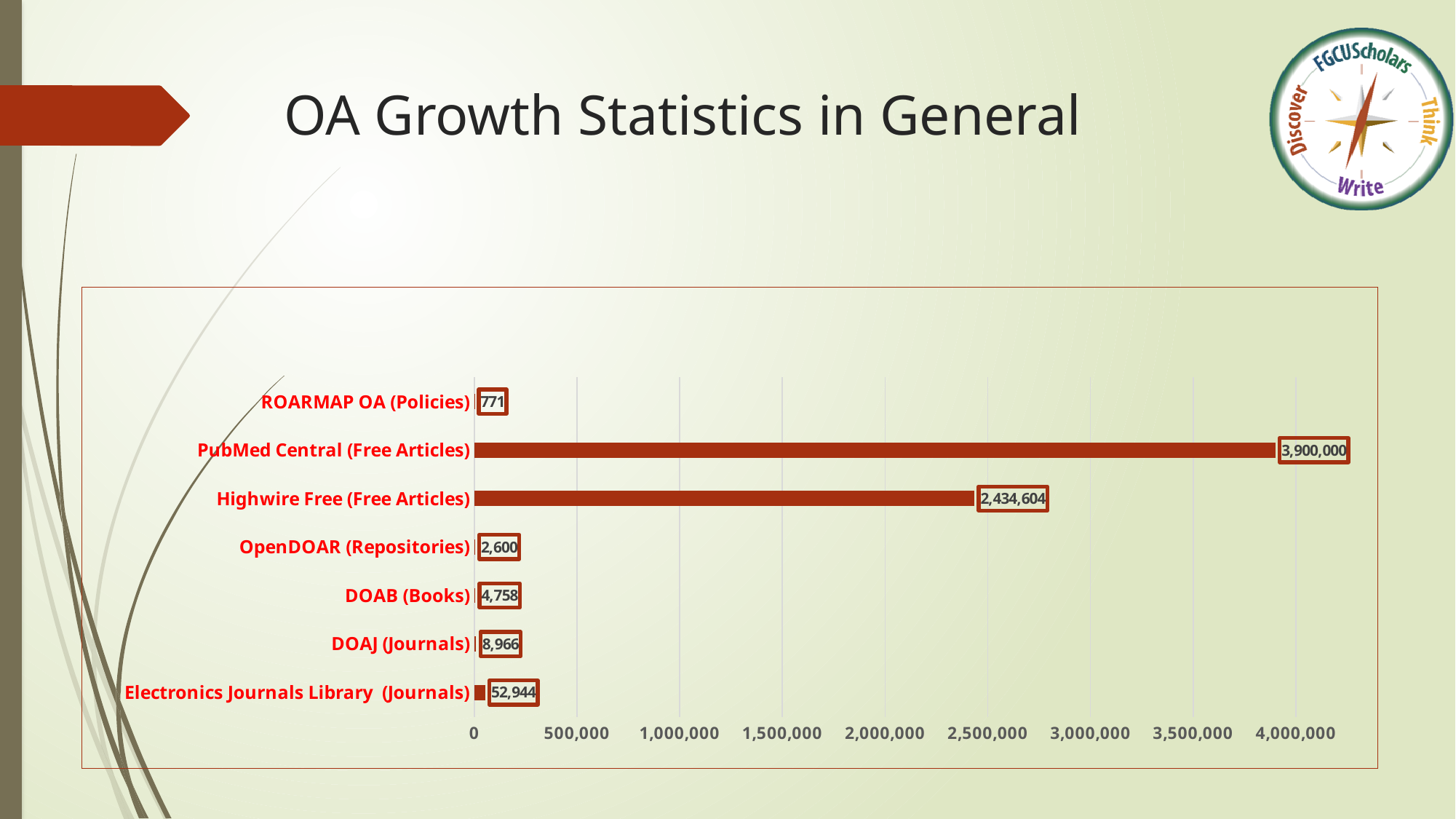
What kind of chart is shown on the slide? Bar chart What is the value for Electronics Journals Library (Journals)? 52,944 Which category has the lowest value? ROARMAP OA (Policies) What is the value for PubMed Central (Free Articles)? 3,900,000 What is the value for ROARMAP OA (Policies)? 771 How many categories are shown in the chart? 7 What is the difference between the values for PubMed Central (Free Articles) and Highwire Free (Free Articles)? 1,465,396 What is the value for Highwire Free (Free Articles)? 2,434,604 What is the title of the slide containing the chart? OA Growth Statistics in General Which is larger, the value for DOAB (Books) or the value for OpenDOAR (Repositories)? DOAB (Books) Which category has the highest value? PubMed Central (Free Articles) What is the value for DOAJ (Journals)? 8,966